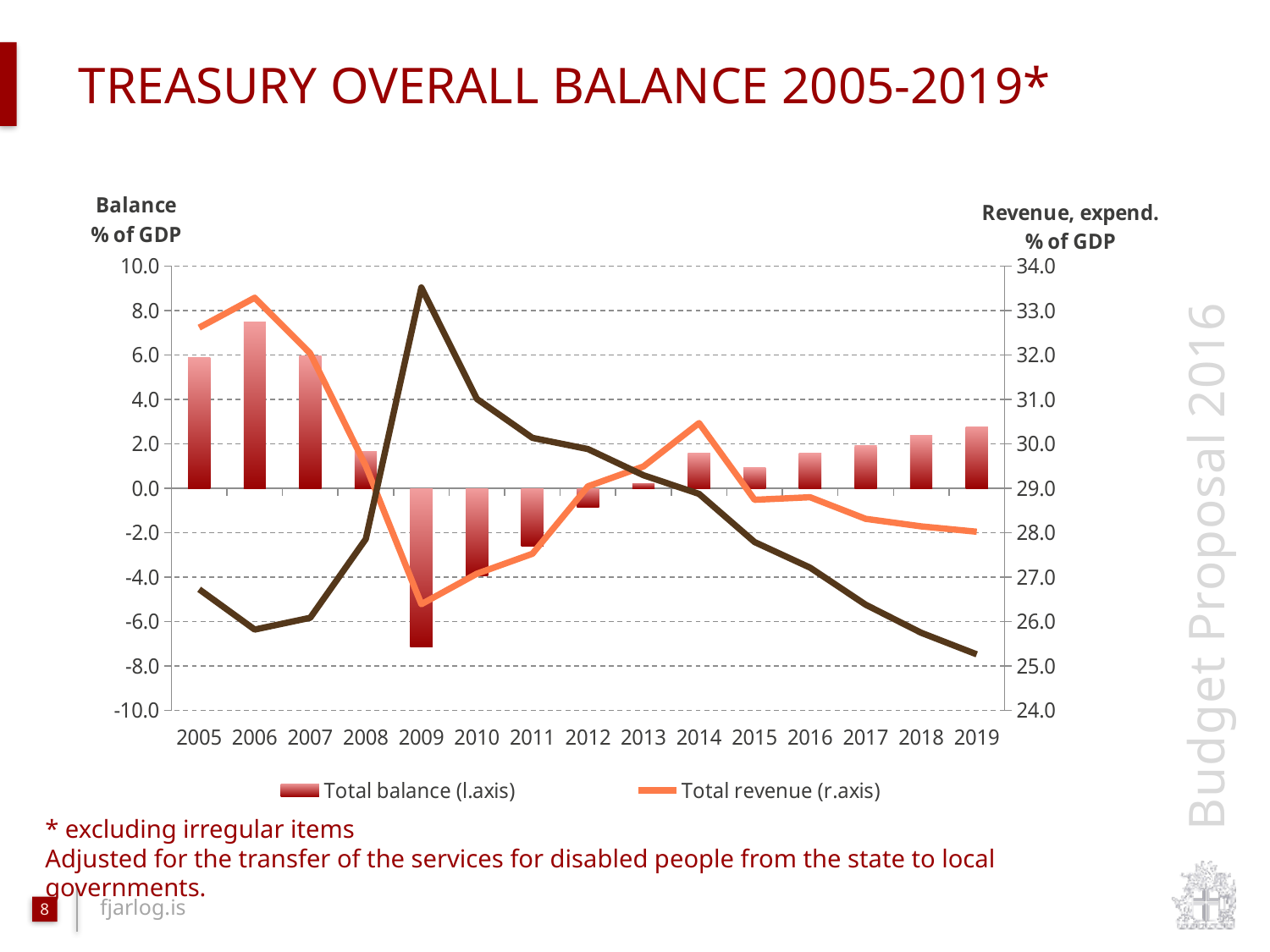
What kind of chart is shown on the slide? A combined bar and line chart How many years are shown on the x axis of the chart? 15 Which year has the larger Total balance, 2005 or 2008? 2005 In which year is the Total balance bar highest? 2006 What is the title of the left vertical axis? Balance % of GDP Does Total revenue rise or fall from 2014 to 2019? fall How many series does the chart's legend list? 2 Is the Total balance value for 2006 greater or less than 6.0? greater Is the Total revenue value for 2009 greater or less than 27.0? less Is the Total balance value for 2009 greater or less than -6.0? less Which year has the larger Total balance, 2010 or 2011? 2011 In which year is the Total balance bar lowest? 2009